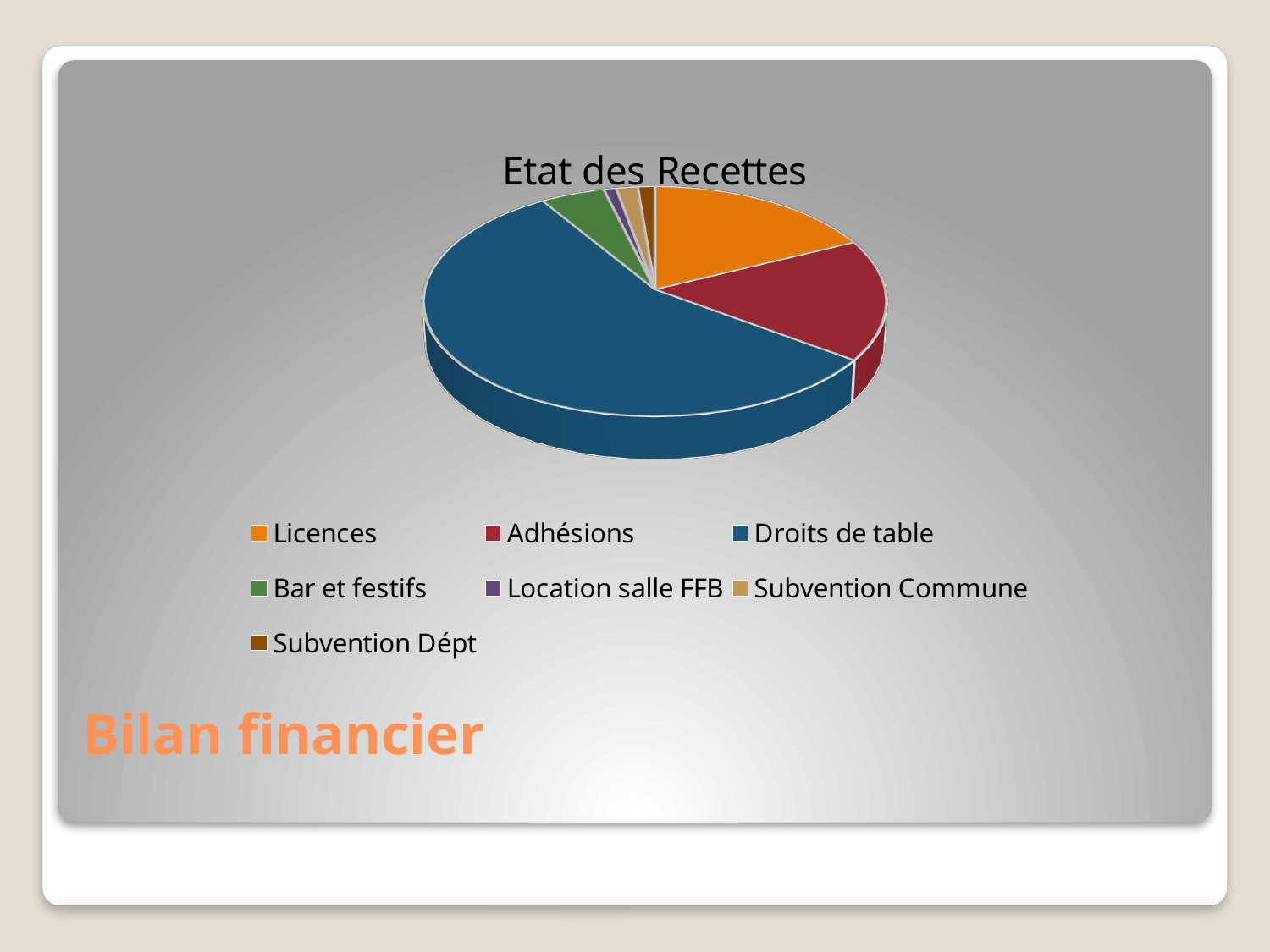
Which is larger, the slice for Bar et festifs or the slice for Location salle FFB? Bar et festifs Which is larger, the slice for Droits de table or the slice for Adhésions? Droits de table What is the title of the chart? Etat des Recettes What colour is the slice for Droits de table? blue Which is larger, the slice for Adhésions or the slice for Bar et festifs? Adhésions Which category has the largest slice of the pie? Droits de table What kind of chart is shown on the slide? pie chart How many categories does the pie chart have? 7